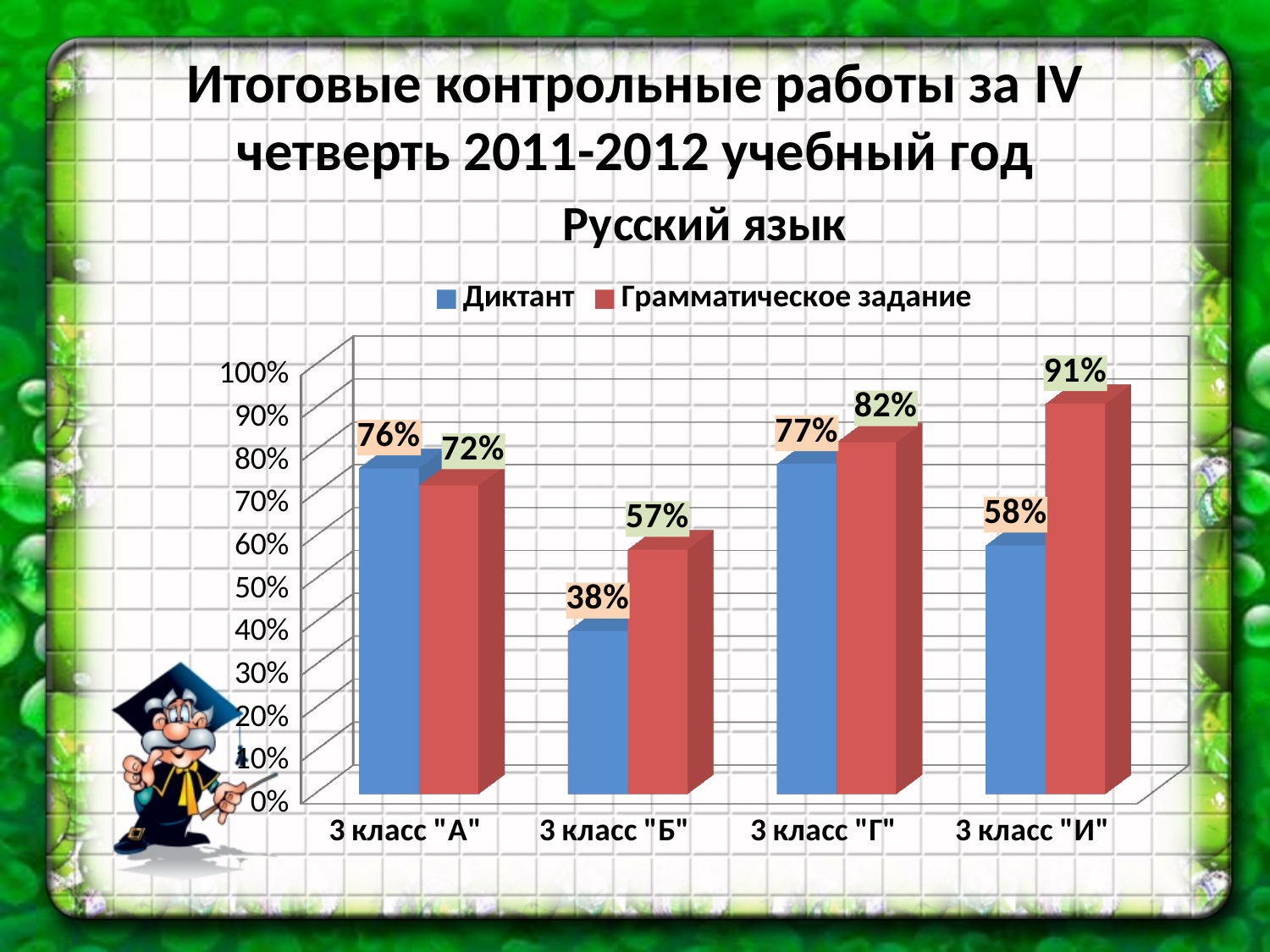
What is the difference between the Грамматическое задание values for 3 класс "Г" and 3 класс "Б"? 25% How many classes are shown on the x axis? 4 Which class has the highest Грамматическое задание value? 3 класс "И" What subject is named in the chart title? Русский язык What is the Диктант value for 3 класс "Г"? 77% What is the Грамматическое задание value for 3 класс "И"? 91% What kind of chart is shown on the slide? Bar chart Which is larger for 3 класс "А": the Диктант value or the Грамматическое задание value? Диктант Which class has the lowest Диктант value? 3 класс "Б" What is the Диктант value for 3 класс "Б"? 38% What is the difference between the Грамматическое задание and Диктант values for 3 класс "И"? 33% How many series does the legend list? 2